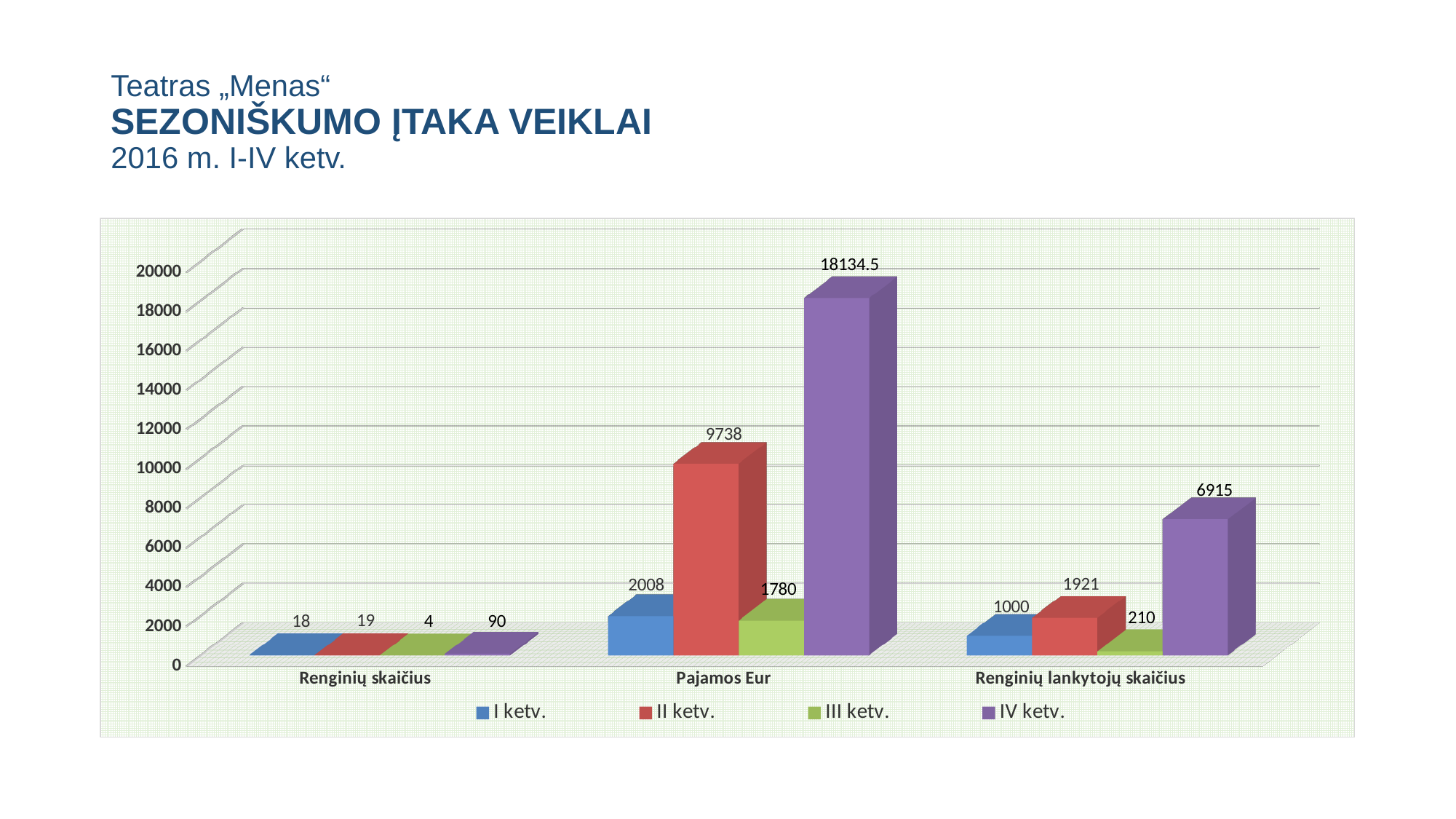
What is the difference between the II ketv. and I ketv. values in the Pajamos Eur category? 7730 What is the value for I ketv. in the Pajamos Eur category? 2008 What is the value for IV ketv. in the Pajamos Eur category? 18134.5 Which quarter has the highest value in the Renginių lankytojų skaičius category? IV ketv. How many categories are shown on the x axis? 3 Which quarter has the lowest value in the Pajamos Eur category? III ketv. What is the value for II ketv. in the Renginių lankytojų skaičius category? 1921 What colour represents IV ketv. in the chart? Purple What kind of chart is shown on the slide? Bar chart How many series does the legend list? 4 Which is larger in the Renginių lankytojų skaičius category: I ketv. or II ketv.? II ketv. What is the value for III ketv. in the Renginių skaičius category? 4